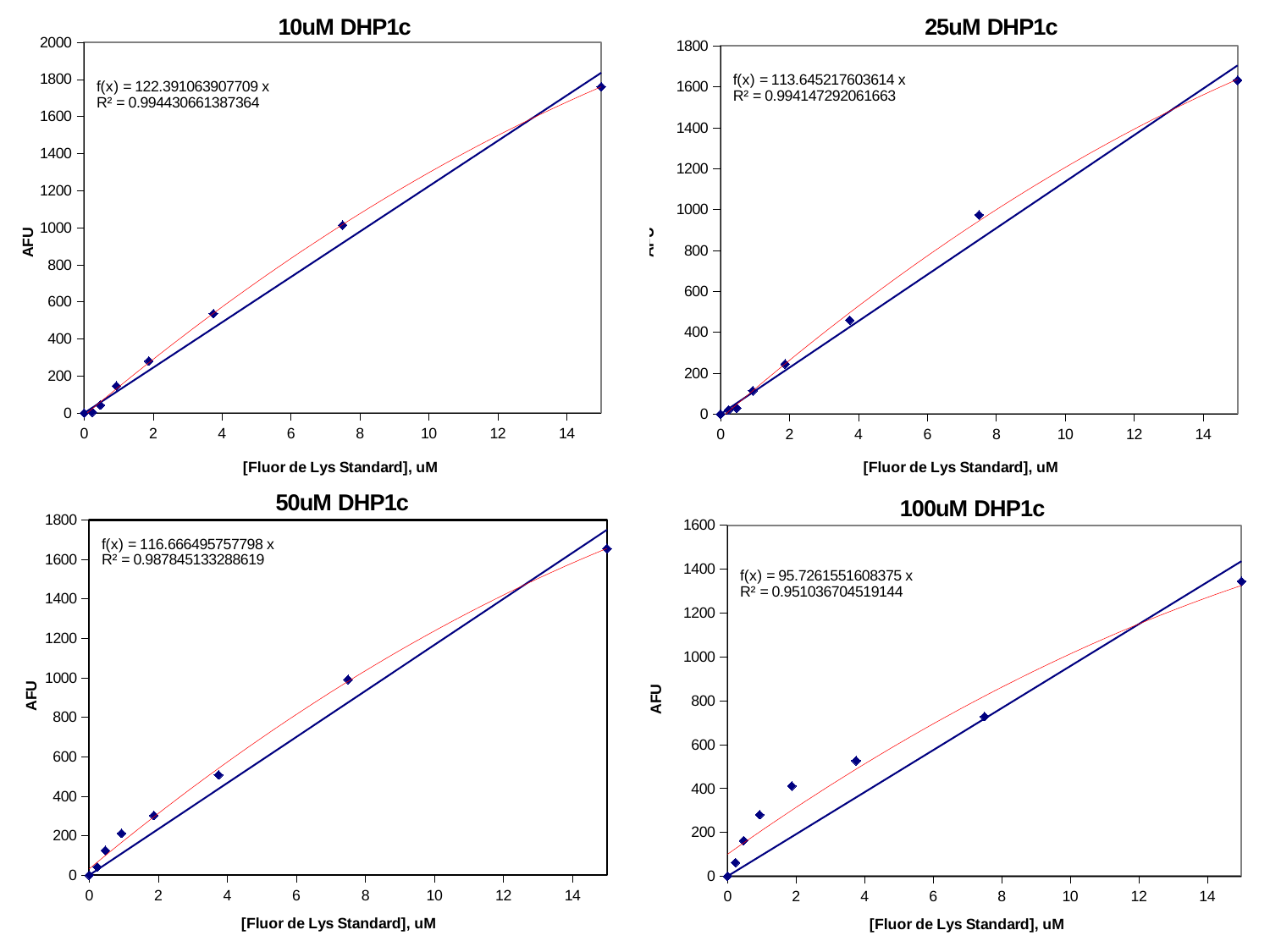
How many charts are shown on the slide? 4 What is the x-axis title on the 25uM DHP1c chart? [Fluor de Lys Standard], uM On the 10uM DHP1c chart, is the AFU value at 14-15 uM greater or less than 1600? greater On the 50uM DHP1c chart, do the AFU values rise or fall as the Fluor de Lys Standard concentration increases? rise On the 100uM DHP1c chart, which point has the larger AFU value: the one near 7.5 uM or the one near 3.75 uM? the one near 7.5 uM Which of the four charts shows the highest slope in its fitted equation f(x)? 10uM DHP1c On the 10uM DHP1c chart, what is the R² value printed? 0.994430661387364 On the 25uM DHP1c chart, is the AFU value of the point near 15 uM greater or less than 1400? greater On the 100uM DHP1c chart, is the AFU value of the point near 7.5 uM greater or less than 800? less What kind of chart is the 10uM DHP1c chart? scatter chart On the 100uM DHP1c chart, what is the fitted equation f(x) printed? f(x) = 95.7261551608375 x Which of the four charts shows the lowest R² value? 100uM DHP1c